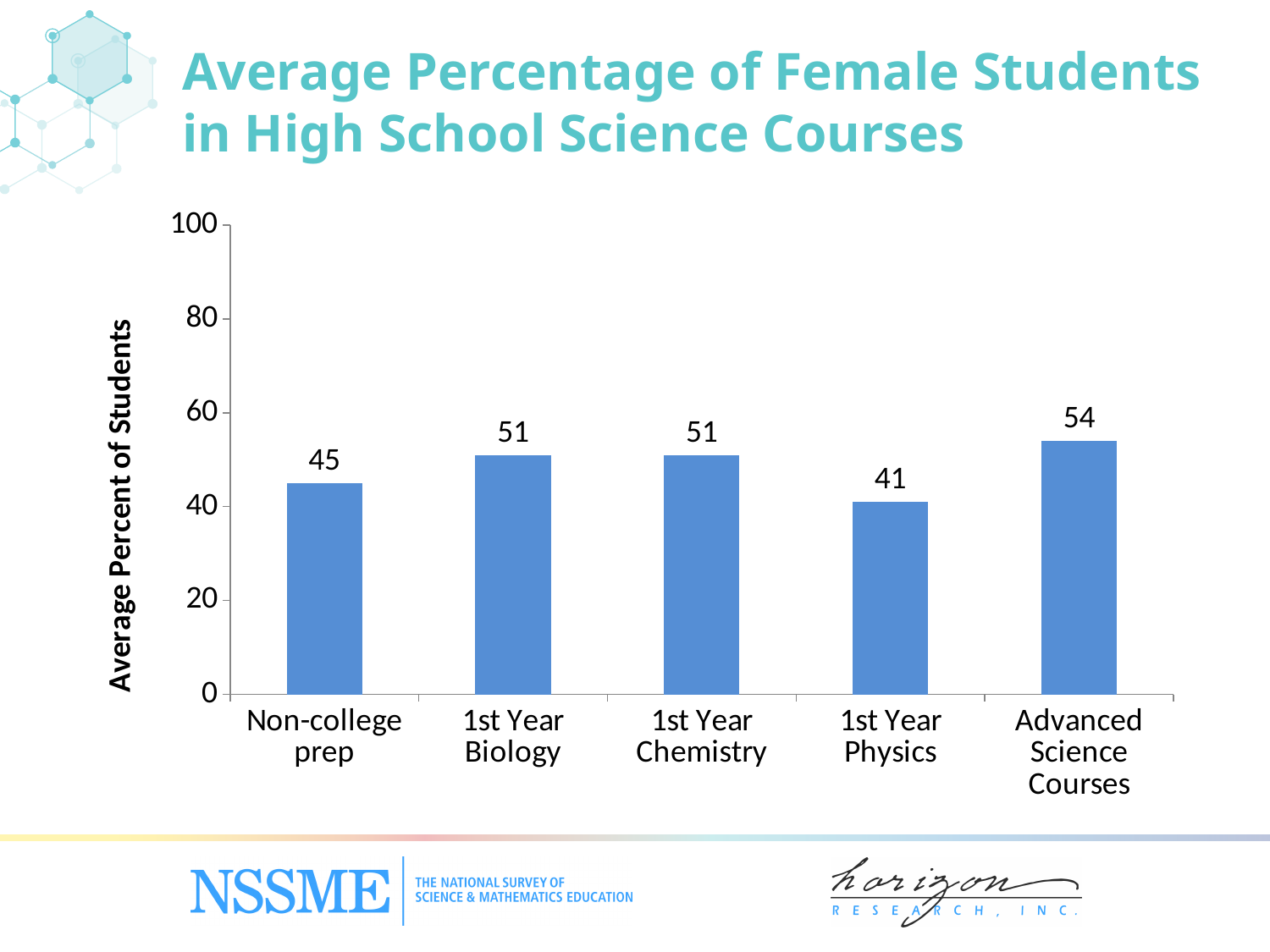
Which course category has the highest average percent of female students? Advanced Science Courses Which course category has the lowest average percent of female students? 1st Year Physics How many course categories are shown on the x axis? 5 What is the difference between the values for 1st Year Biology and Non-college prep? 6 What kind of chart is shown on the slide? bar chart What is the label of the y axis? Average Percent of Students What is the average percent of female students in 1st Year Physics? 41 Is the value for 1st Year Physics greater or less than 60? less What is the difference between the values for Advanced Science Courses and 1st Year Physics? 13 What is the average percent of female students in Advanced Science Courses? 54 What is the average percent of female students in Non-college prep courses? 45 Which is larger, the value for Non-college prep or the value for 1st Year Chemistry? 1st Year Chemistry